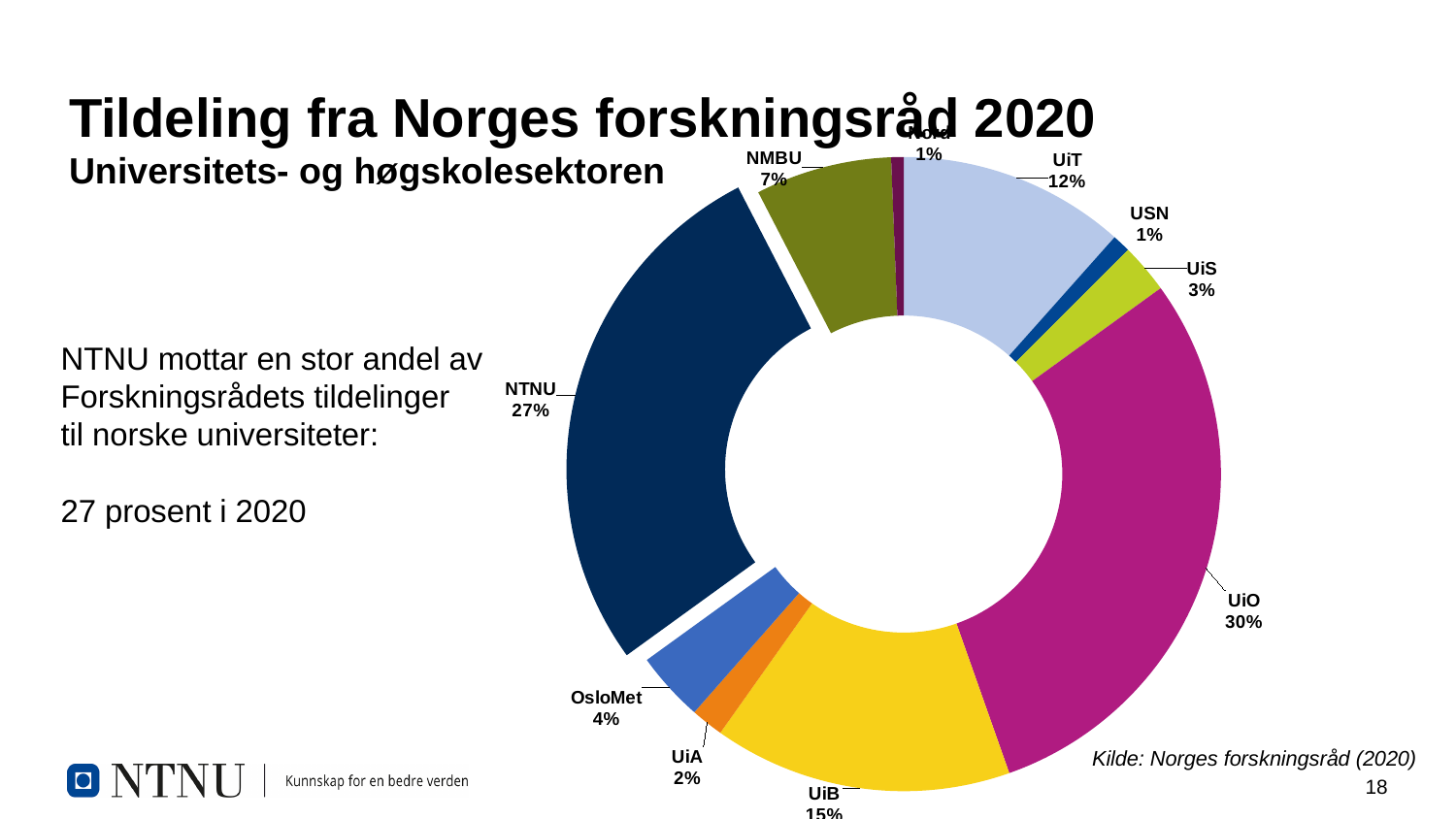
What share is shown for OsloMet? 4% What percentage does NMBU receive? 7% What source is cited for the chart data? Norges forskningsråd (2020) What is the value shown for UiB? 15% What is the difference in percentage points between UiO and NTNU? 3 What kind of chart is shown on the slide? doughnut chart Which institution has the largest share in the chart? UiO What share of the allocation does NTNU receive according to the chart? 27% Which is larger, the share for UiT or the share for UiB? UiB What is the combined share of UiS and USN? 4% What is the title of the slide containing the chart? Tildeling fra Norges forskningsråd 2020 What percentage is shown for UiO? 30%